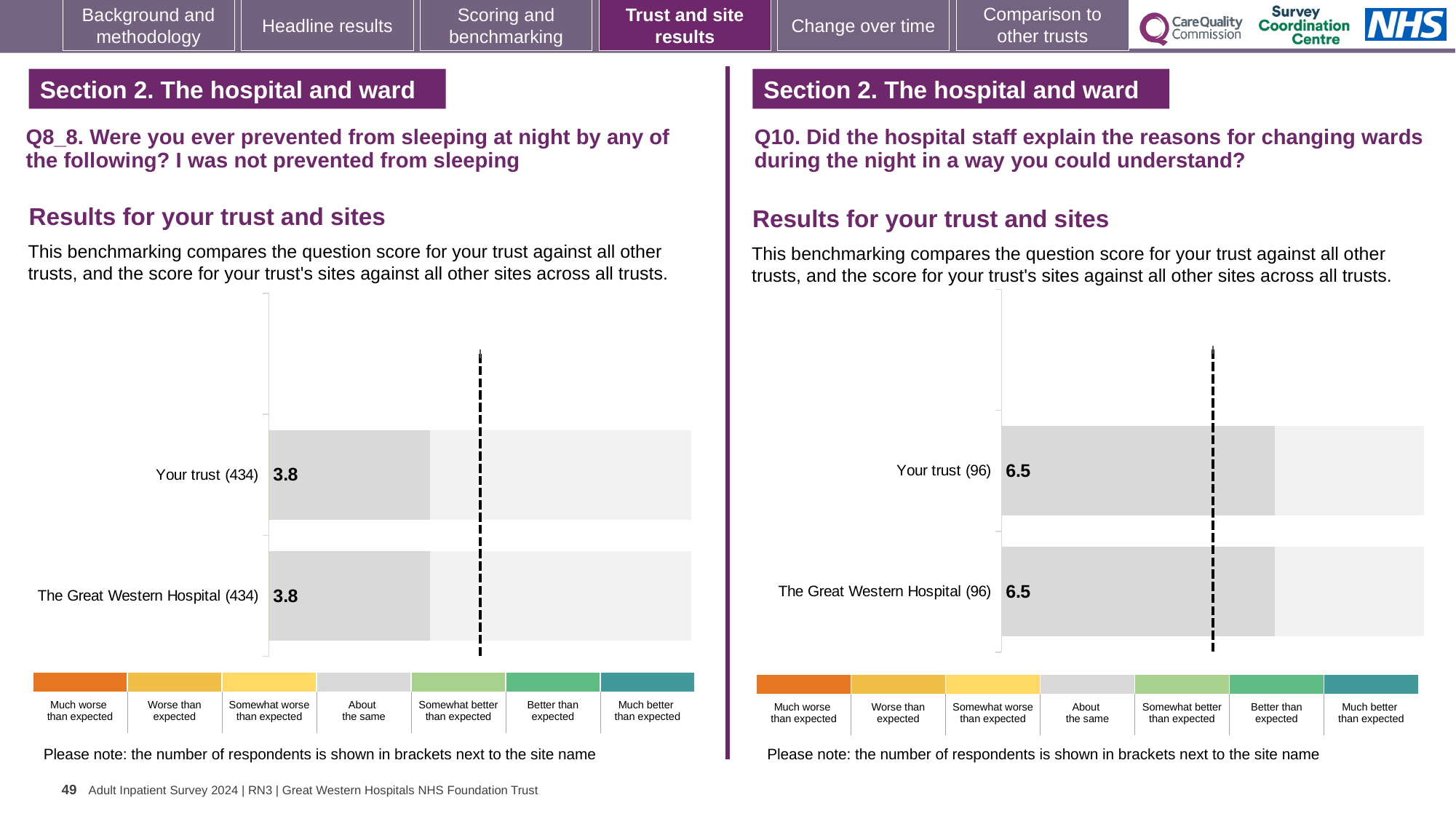
What kind of chart is used on the left (Q8_8)? Bar chart On the right chart (Q10), how many bars are plotted? 2 On the left chart (Q8_8), how many respondents are shown in brackets next to Your trust? 434 On the right chart (Q10), how many respondents are shown in brackets next to The Great Western Hospital? 96 On the left chart (Q8_8), what is the score for The Great Western Hospital? 3.8 On the right chart (Q10), what is the score for Your trust? 6.5 Is the score for Your trust on the right chart (Q10) larger or smaller than the score for Your trust on the left chart (Q8_8)? Larger On the left chart (Q8_8), how many bars are plotted? 2 On the left chart (Q8_8), what is the difference between the score for Your trust and the score for The Great Western Hospital? 0.0 On the left chart (Q8_8), what is the score for Your trust? 3.8 On the right chart (Q10), what is the difference between the score for Your trust and the score for The Great Western Hospital? 0.0 On the right chart (Q10), what is the score for The Great Western Hospital? 6.5